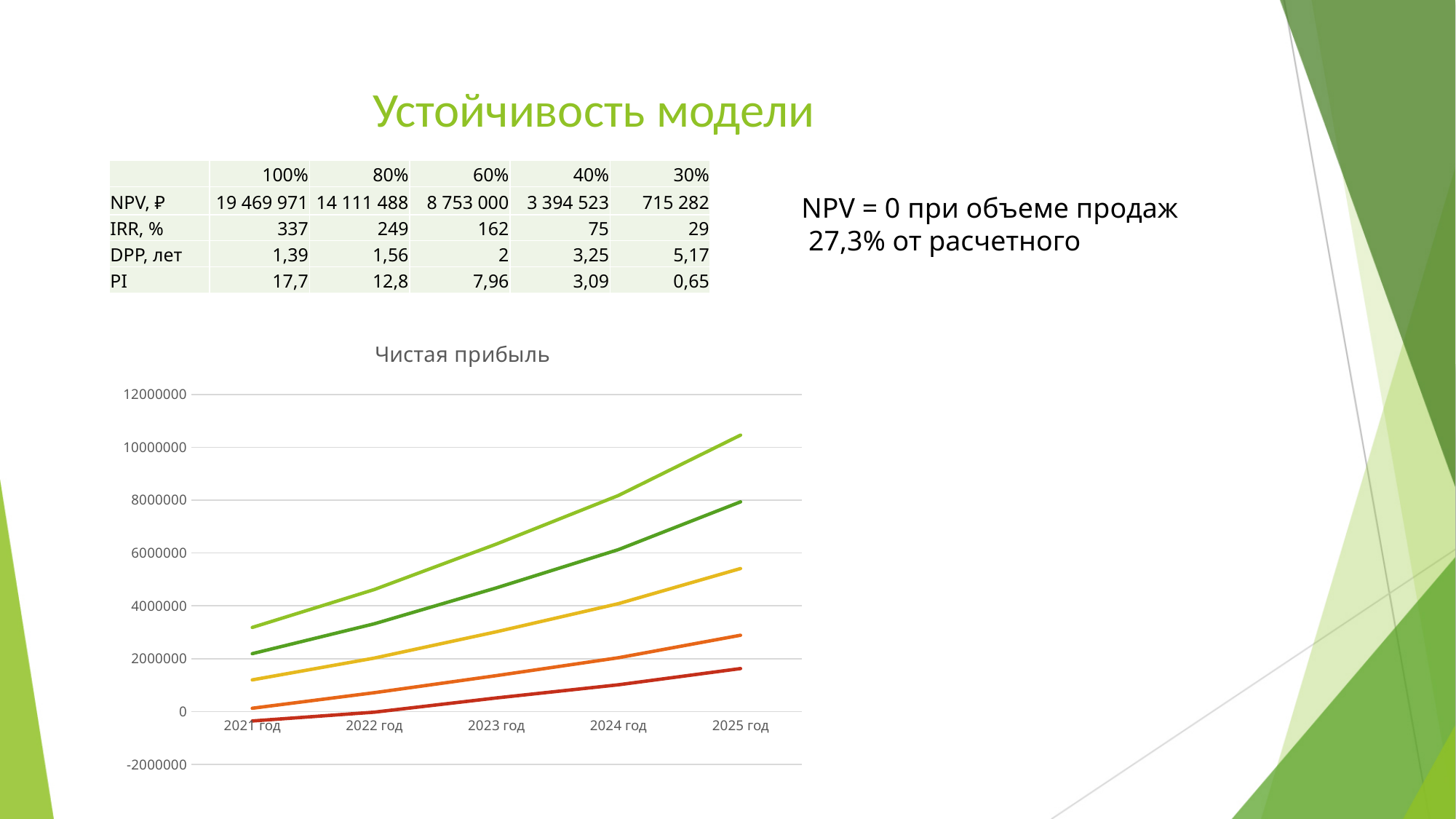
Does the light green line rise or fall from 2021 год to 2025 год? rise Is the value of the red line for 2021 год greater or less than 0? less Which line has the highest value for 2025 год? the light green line How many years are shown along the x axis of the chart? 5 What kind of chart is shown on the slide? line chart Does the red line rise or fall from 2021 год to 2025 год? rise Is the value of the yellow line for 2025 год greater or less than 6000000? less Is the value of the dark green line for 2023 год greater or less than 4000000? greater What is the title of the chart on the slide? Чистая прибыль Which line has the lowest value for 2025 год? the red line How many lines are plotted on the chart? 5